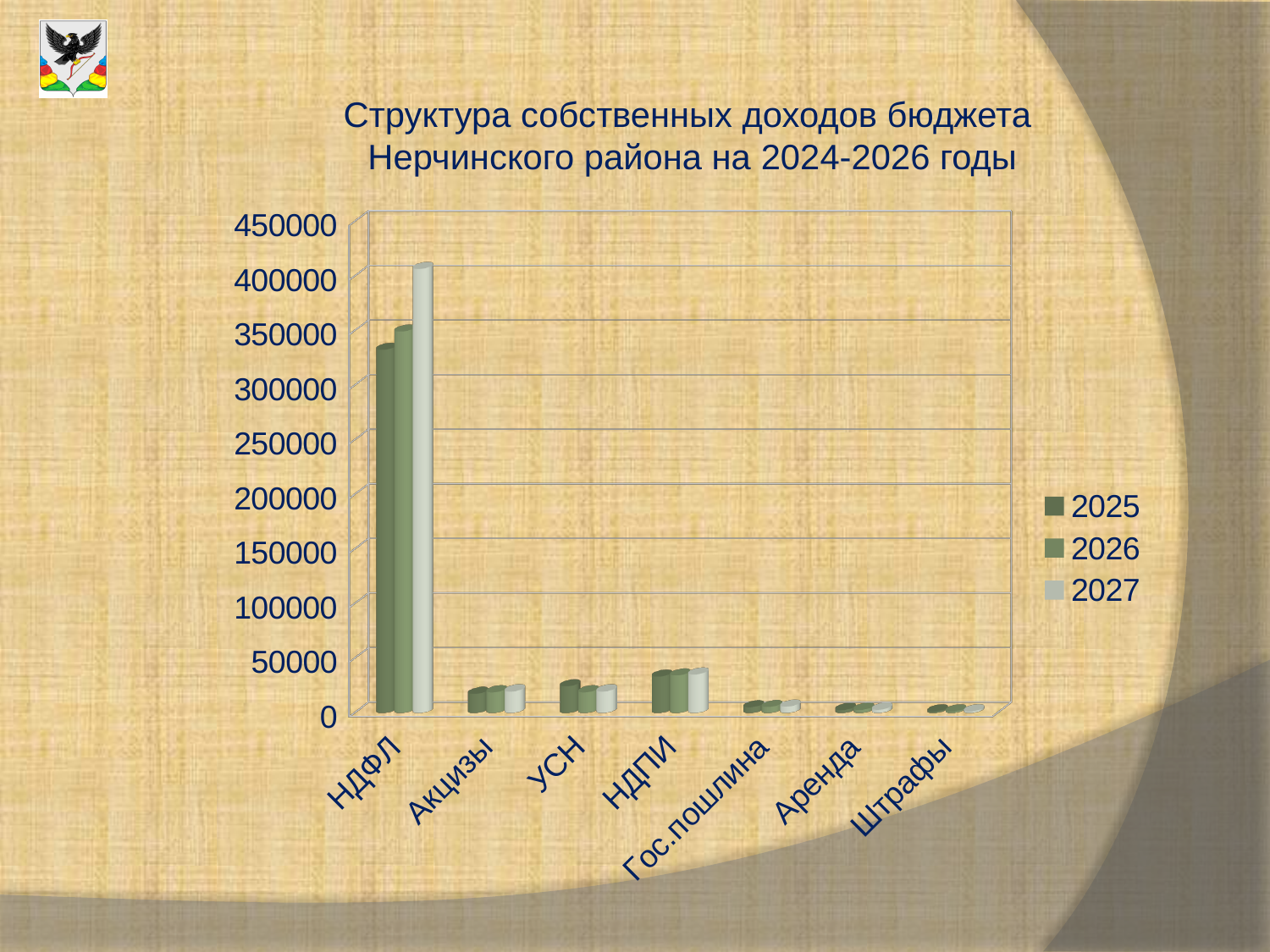
What kind of chart is shown on the slide? bar chart What is the title of the chart? Структура собственных доходов бюджета Нерчинского района на 2024-2026 годы Is the value for НДФЛ in 2027 greater or less than 350000? greater Is the value for НДФЛ in 2025 greater or less than 300000? greater Do the values for НДФЛ rise or fall from 2025 to 2027? rise How many series does the chart's legend list? 3 Is the value for НДПИ in 2025 greater or less than 50000? less For 2025, which is larger: the value for Акцизы or the value for НДПИ? НДПИ Which series is shown in the lightest colour in the legend? 2027 How many categories are shown on the x axis of the chart? 7 For НДФЛ, which is larger: the 2025 value or the 2027 value? 2027 Which category has the highest values in the chart? НДФЛ